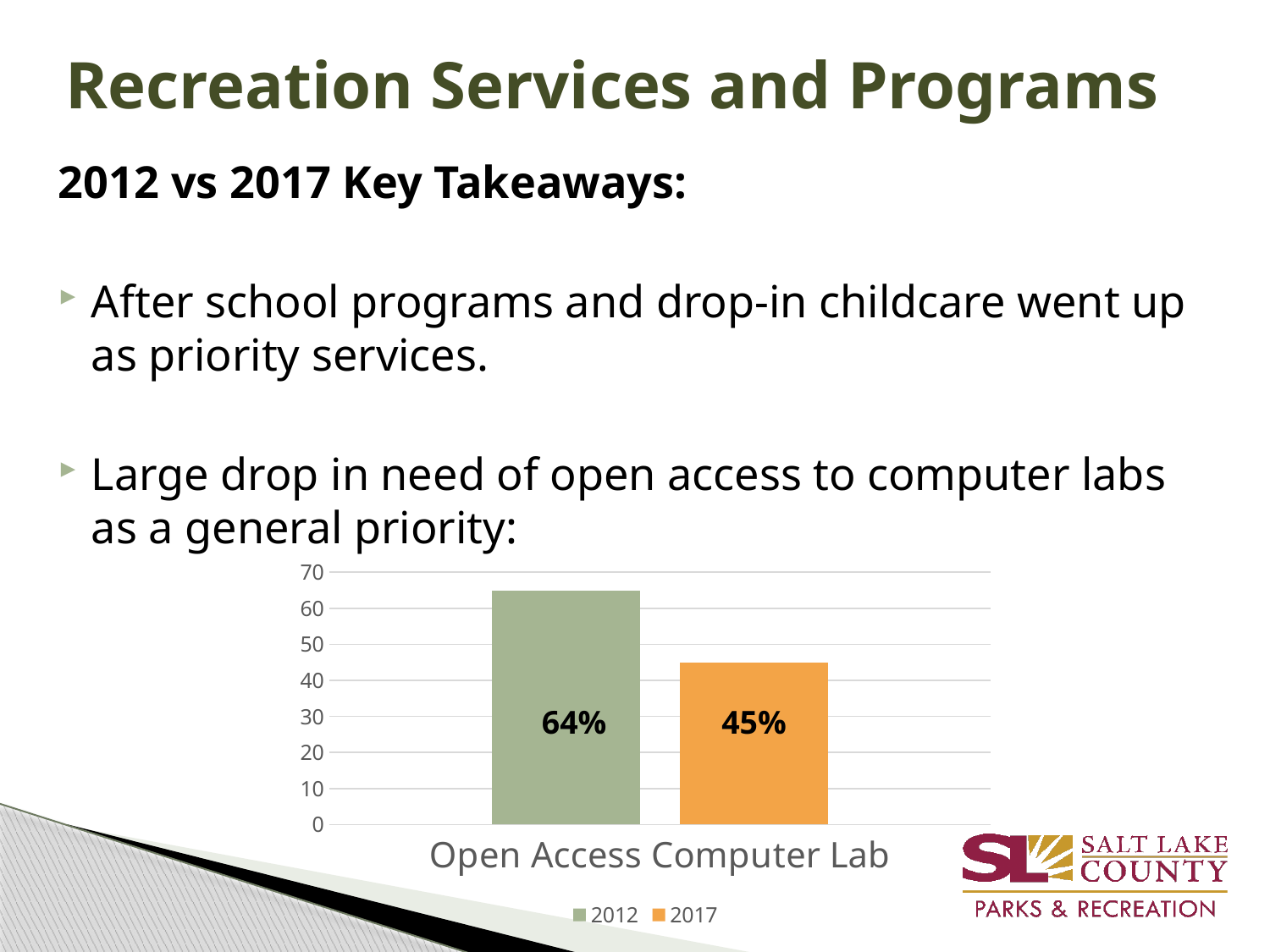
Is the value for 2017 greater or less than 50? less How many categories are shown on the x axis? 1 Which series has the lowest value in the chart? 2017 Is the value for 2012 greater or less than 60? greater How many series does the legend list? 2 What is the value for 2017 for Open Access Computer Lab? 45% What is the value for 2012 for Open Access Computer Lab? 64% What is the category label on the x axis of the chart? Open Access Computer Lab What kind of chart is shown on the slide? Bar chart Which series is shown in orange in the chart? 2017 Which series has the higher value for Open Access Computer Lab, 2012 or 2017? 2012 What is the difference between the 2012 and 2017 values for Open Access Computer Lab? 19%